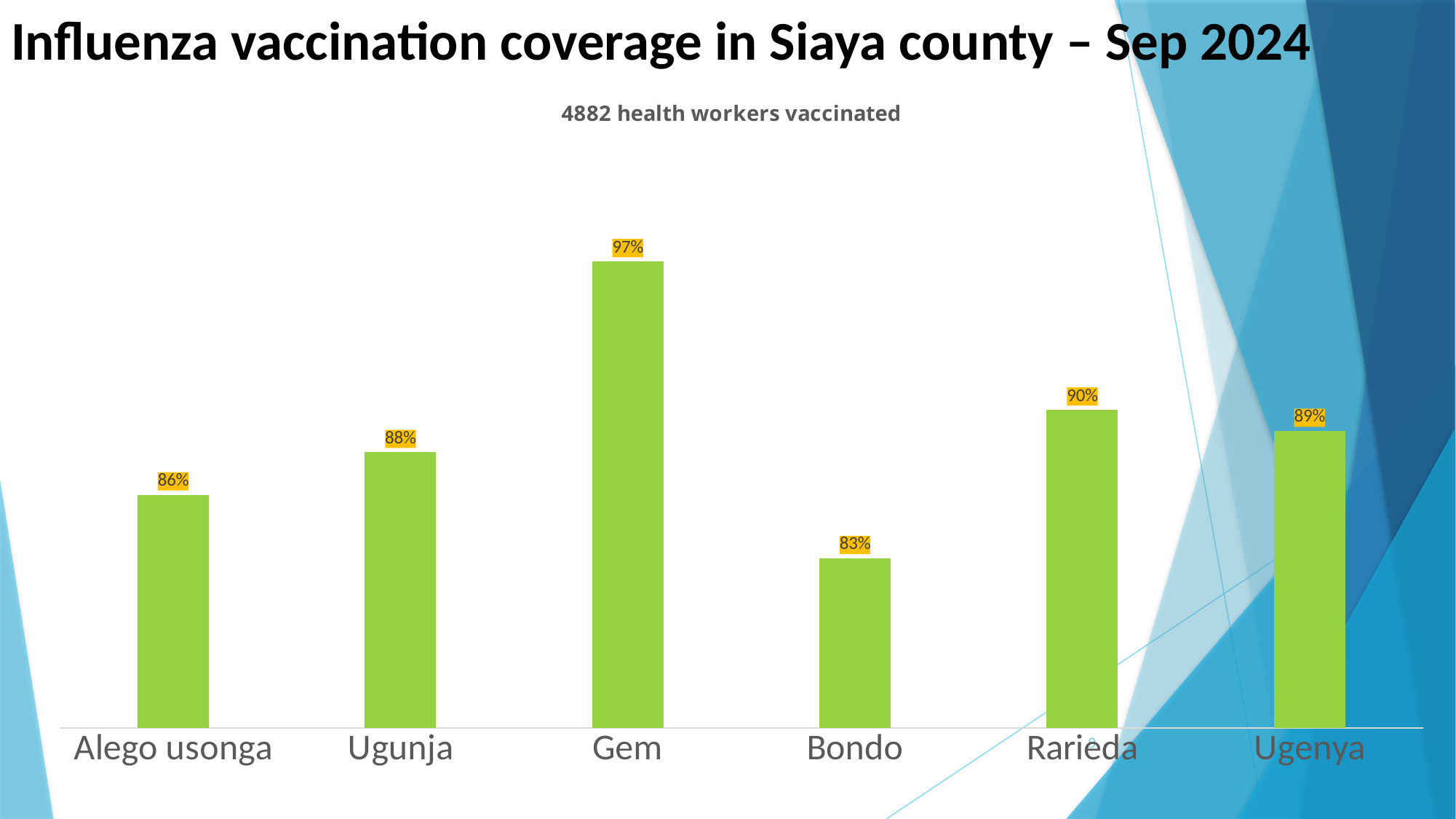
What is the chart's title? 4882 health workers vaccinated Which has higher coverage, Ugenya or Alego usonga? Ugenya Which sub-county has the highest vaccination coverage? Gem What is the vaccination coverage for Gem? 97% What is the difference in coverage between Gem and Bondo? 14% What is the vaccination coverage for Alego usonga? 86% What type of chart is shown on the slide? Bar chart Which sub-county has the lowest vaccination coverage? Bondo What is the vaccination coverage for Bondo? 83% What is the vaccination coverage for Rarieda? 90% What is the difference in coverage between Rarieda and Ugunja? 2% How many sub-counties are shown on the chart? 6